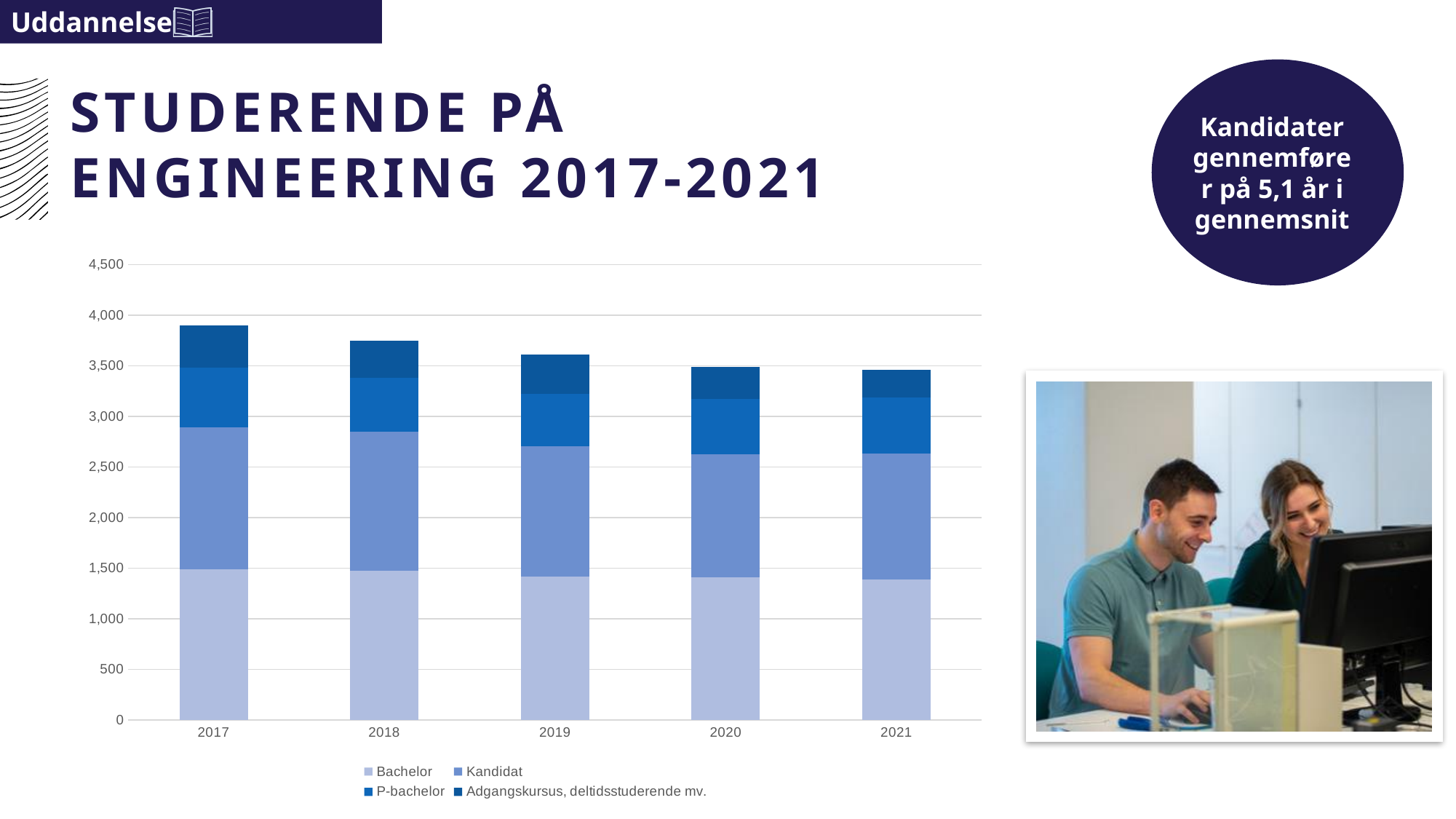
How many years are shown on the x axis of the chart? 5 What kind of chart is shown on the slide? Stacked bar chart Which is larger, the total for 2017 or the total for 2019? 2017 Do the total bar heights rise or fall from 2017 to 2021? Fall Is the Bachelor value for 2021 greater or less than 1,500? less Which series forms the bottom segment of each stacked bar? Bachelor Which year has the highest total number of students in the chart? 2017 How many series does the chart's legend list? 4 Is the total for 2019 greater or less than 4,000? less Is the total for 2017 greater or less than 3,500? greater Which series is listed first in the chart's legend? Bachelor